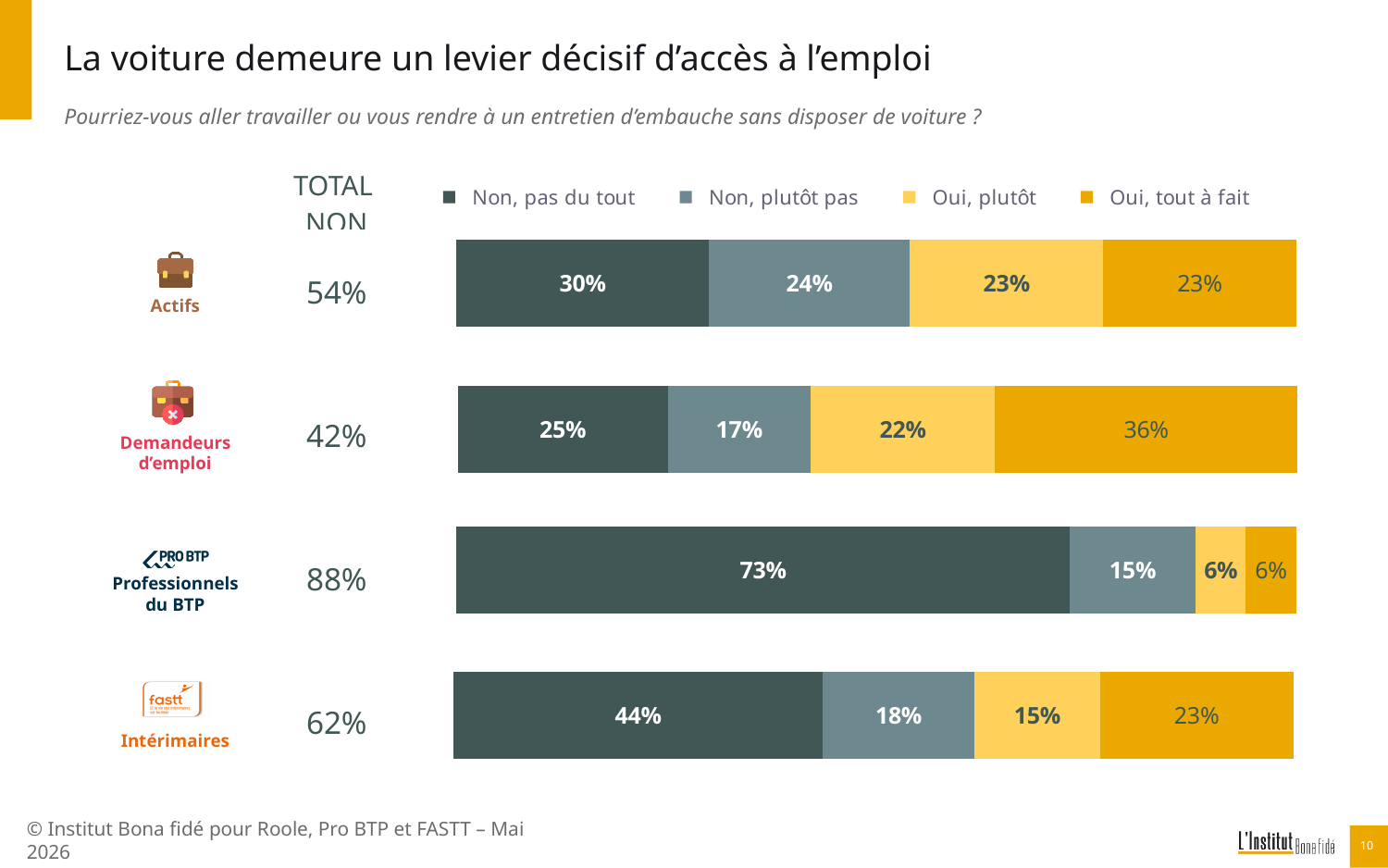
Which category has the highest value for "Non, pas du tout"? Professionnels du BTP What is the value of "Non, pas du tout" for Professionnels du BTP? 73% What is the difference between the "Non, pas du tout" values for Intérimaires and Actifs? 14% How many categories are plotted in the chart? 4 What is the value of "Oui, tout à fait" for Demandeurs d'emploi? 36% What is the combined total of "Non, pas du tout" and "Non, plutôt pas" for Intérimaires? 62% What is the value of "Non, plutôt pas" for Intérimaires? 18% What is the TOTAL NON value shown for Demandeurs d'emploi? 42% How many series does the legend list? 4 What kind of chart is shown on the slide? Stacked bar chart Which category has the lowest value for "Oui, tout à fait"? Professionnels du BTP Which is larger: the "Oui, plutôt" value for Actifs or for Intérimaires? Actifs